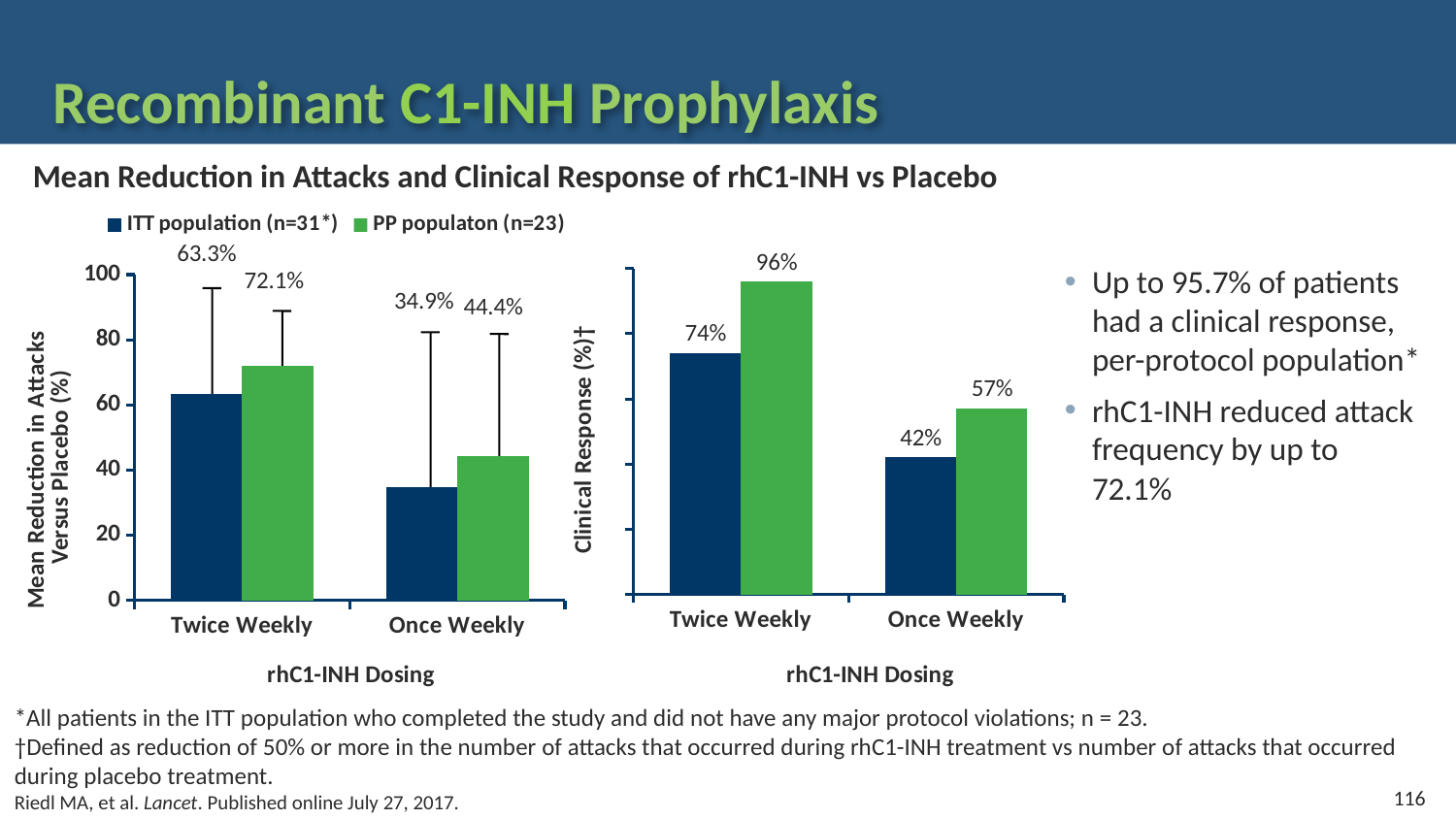
In the right chart (Clinical Response), what is the value for the PP population at Twice Weekly dosing? 96% In the right chart (Clinical Response), which bar has the lowest value? ITT population, Once Weekly (42%) In the left chart (Mean Reduction in Attacks Versus Placebo), what is the value for the PP population at Once Weekly dosing? 44.4% In the left chart (Mean Reduction in Attacks Versus Placebo), what is the value for the ITT population at Twice Weekly dosing? 63.3% In the left chart, is the mean reduction in attacks for the ITT population at Twice Weekly dosing greater or less than 60? greater In the left chart (Mean Reduction in Attacks Versus Placebo), which bar has the highest value? PP population, Twice Weekly (72.1%) In the right chart (Clinical Response), which is larger: the PP population at Once Weekly or the ITT population at Twice Weekly? ITT population at Twice Weekly (74%) In the right chart (Clinical Response), what is the difference between the PP and ITT populations at Twice Weekly dosing? 22% In the right chart (Clinical Response), what is the value for the ITT population at Once Weekly dosing? 42% In the left chart (Mean Reduction in Attacks Versus Placebo), what is the difference between the PP and ITT populations at Once Weekly dosing? 9.5% What type of chart is the left chart (Mean Reduction in Attacks Versus Placebo)? Bar chart How many series does the legend list? 2